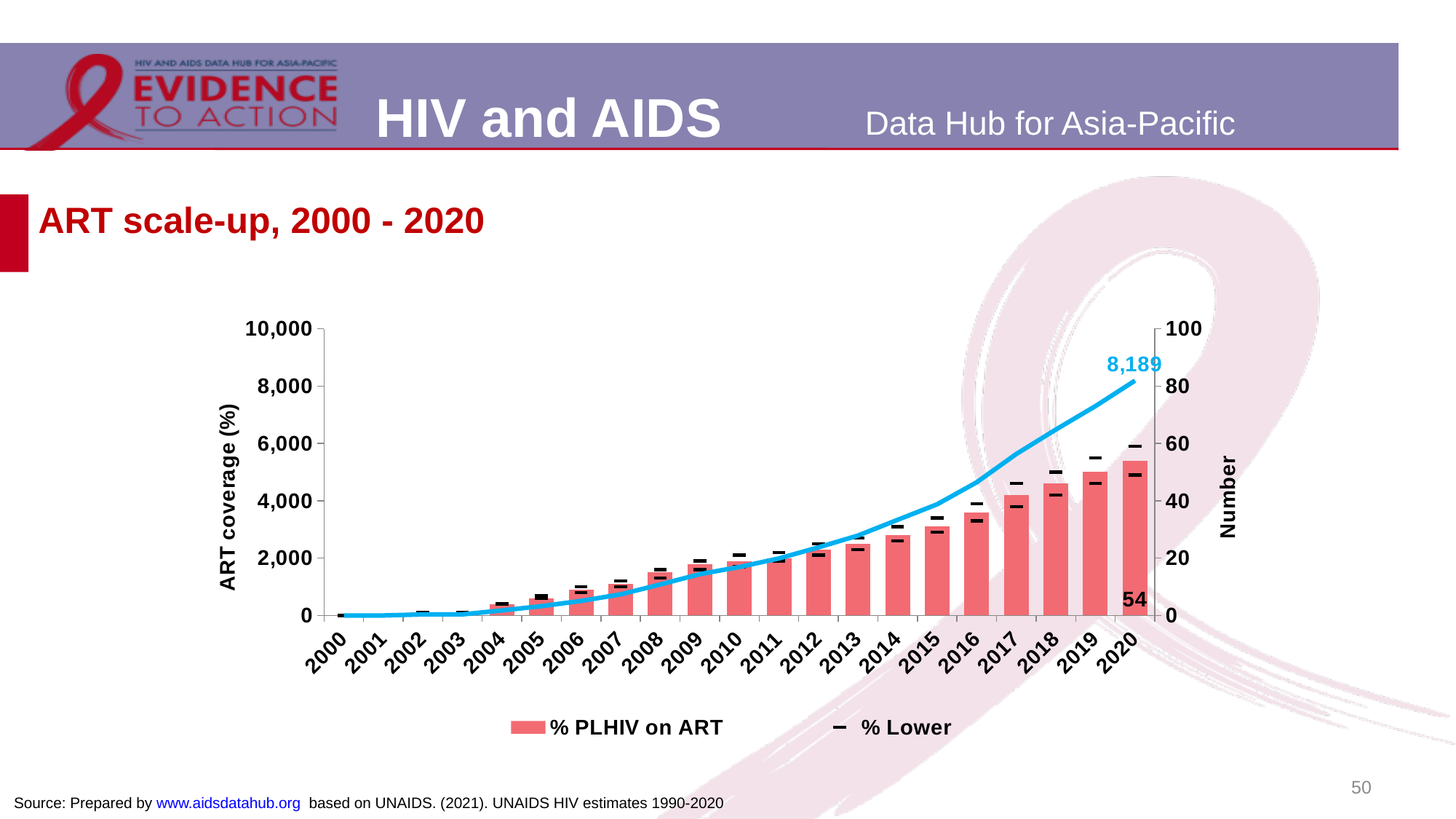
How many entries does the legend list? 2 What are the two entries listed in the chart legend? % PLHIV on ART and % Lower Which year has the tallest % PLHIV on ART bar? 2020 What value is labelled on the blue line at 2020? 8,189 What is the title of the chart? ART scale-up, 2000 - 2020 Which year has the larger % PLHIV on ART bar, 2010 or 2020? 2020 Do the % PLHIV on ART bars generally rise or fall from 2000 to 2020? rise What is the data label shown on the % PLHIV on ART bar for 2020? 54 What kind of chart is shown on the slide? Combined bar and line chart How many years are shown on the x axis? 21 Is the % PLHIV on ART bar for 2016 greater or less than 40 on the right-hand axis? less Is the % PLHIV on ART bar for 2019 greater or less than 40 on the right-hand axis? greater